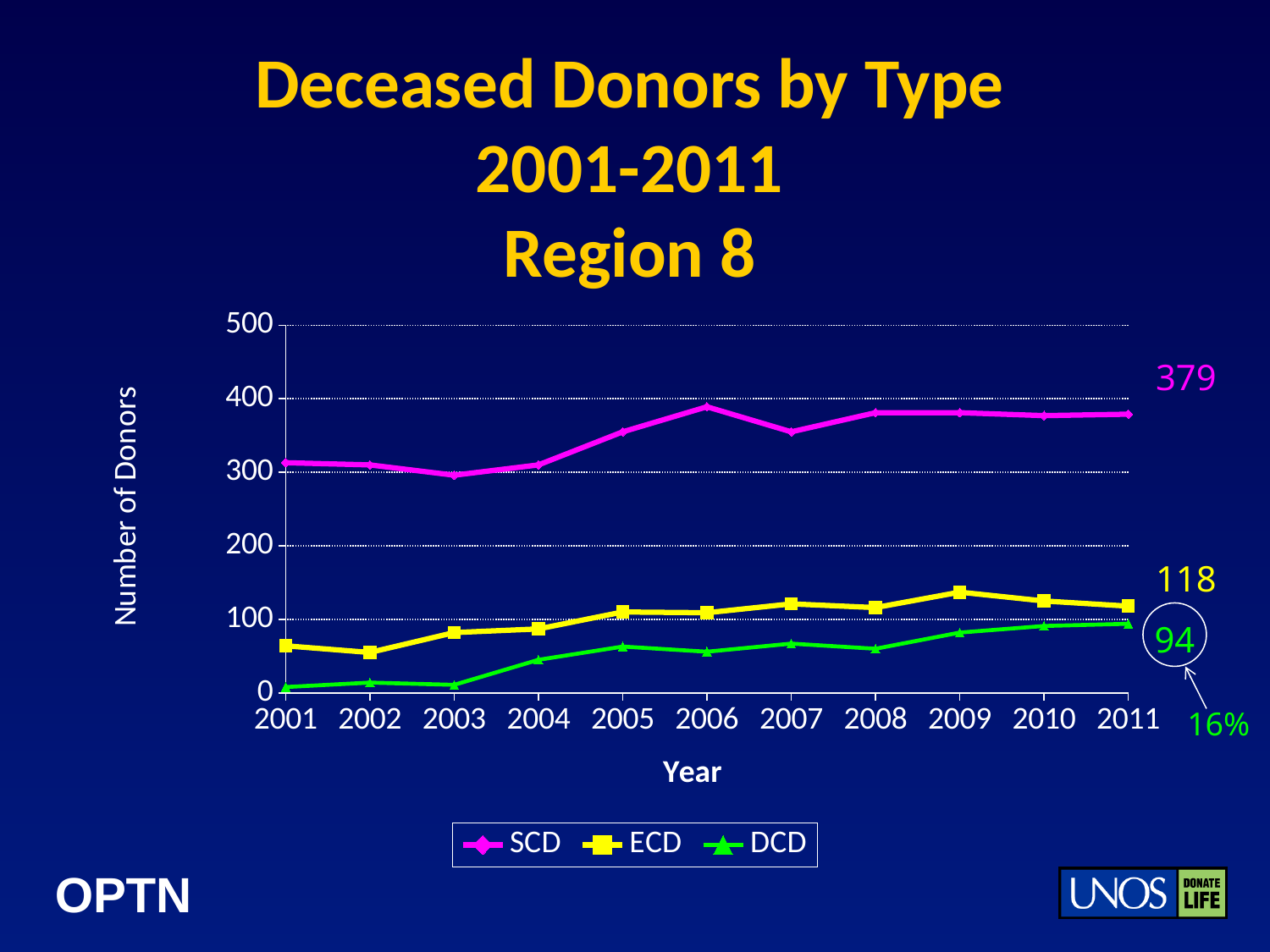
What is the value for SCD in 2011? 379 Which series has the lowest value in 2011? DCD Is the value for DCD in 2001 greater or less than 100? less What is the difference between the ECD and DCD values in 2011? 24 What kind of chart is shown on the slide? Line chart What is the value for ECD in 2011? 118 Which series has the highest value in 2011? SCD Is the value for SCD in 2006 greater or less than 350? greater How many years are shown on the x axis? 11 How many series does the legend list? 3 What is the value for DCD in 2011? 94 What is the difference between the SCD and ECD values in 2011? 261